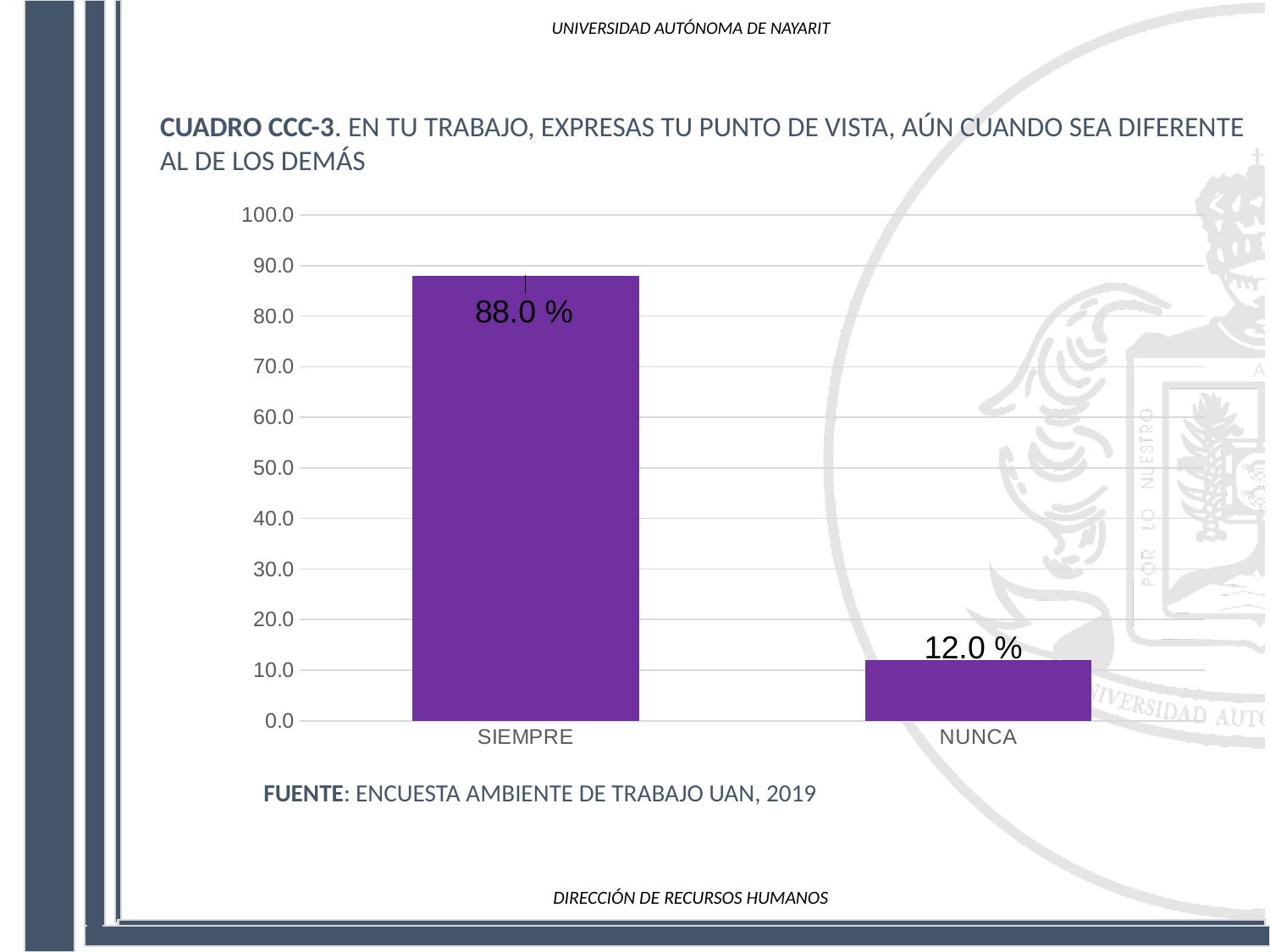
Is the value for NUNCA greater or less than 20.0? less What kind of chart is shown on the slide? Bar chart What is the difference between the values for SIEMPRE and NUNCA? 76.0 % How many categories are shown on the x axis? 2 What is the value for SIEMPRE? 88.0 % What is the total of the two values shown in the chart? 100.0 % What source is cited below the chart? ENCUESTA AMBIENTE DE TRABAJO UAN, 2019 Which category has the lowest value? NUNCA Which category has the highest value? SIEMPRE Is the value for SIEMPRE greater or less than 80.0? greater What is the value for NUNCA? 12.0 % Which is larger, the value for SIEMPRE or the value for NUNCA? SIEMPRE